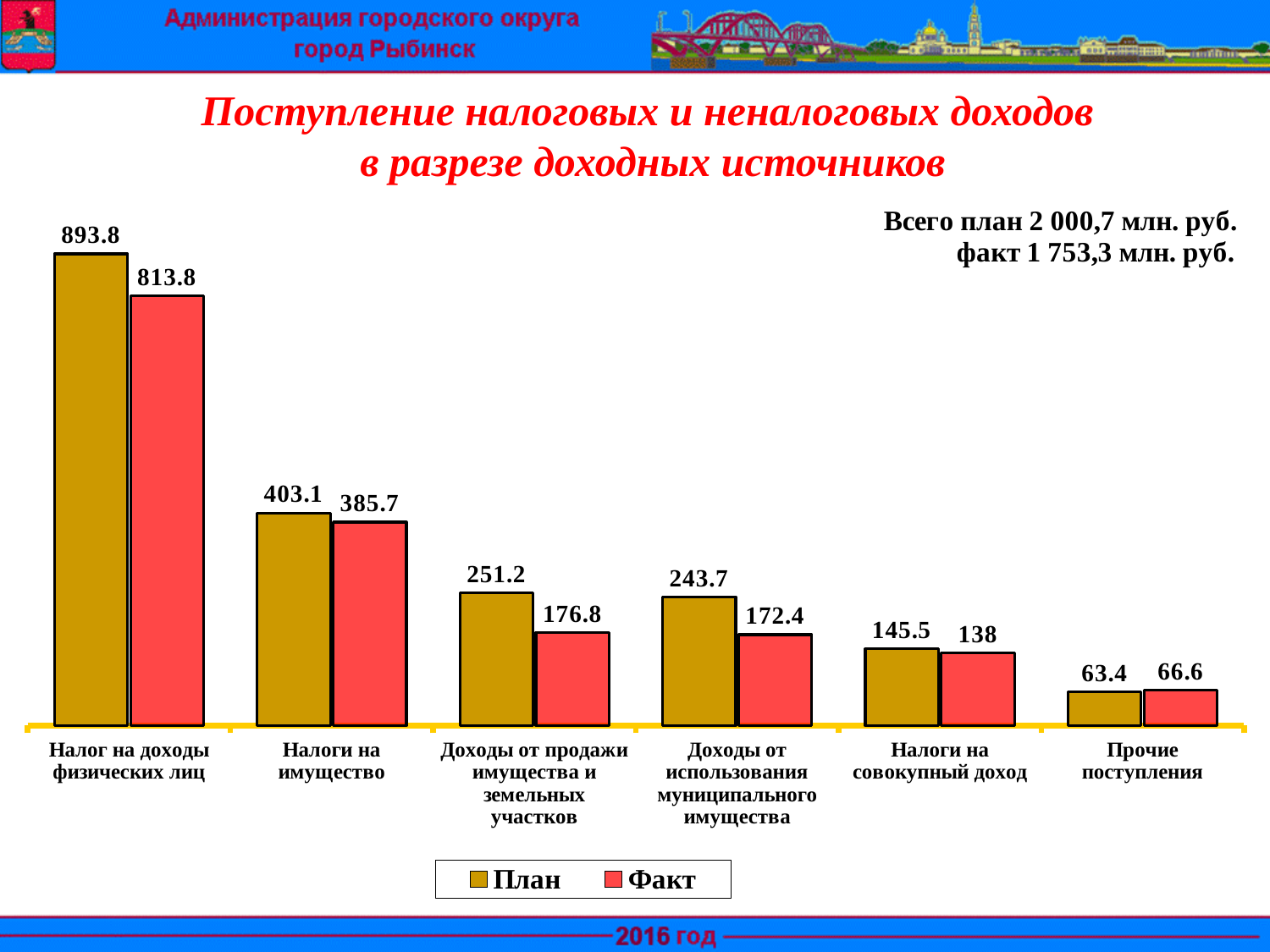
Which colour represents the Факт series in the legend? Red What is the Факт value for Налоги на совокупный доход? 138 What kind of chart is shown on the slide? Bar chart How many series does the legend list? 2 Which category has the highest План value? Налог на доходы физических лиц What is the difference between the План and Факт values for Налог на доходы физических лиц? 80 Which category has the lowest Факт value? Прочие поступления What is the Факт value for Доходы от продажи имущества и земельных участков? 176.8 For Прочие поступления, which is larger: План or Факт? Факт What is the difference between the План and Факт values for Доходы от использования муниципального имущества? 71.3 How many categories are shown on the x axis? 6 What is the План value for Налог на доходы физических лиц? 893.8